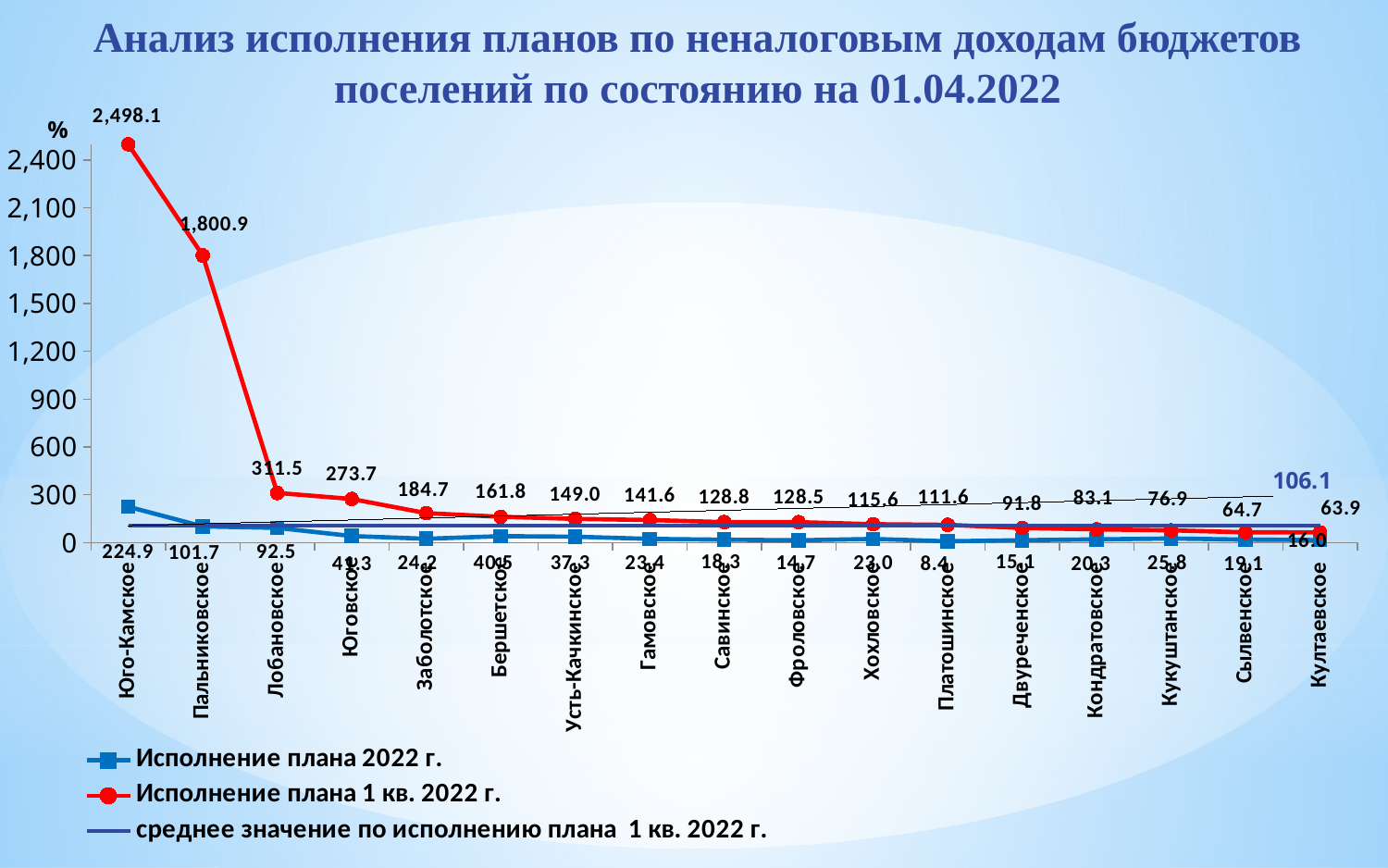
What is the difference between the 'Исполнение плана 1 кв. 2022 г.' values for Юго-Камское and Пальниковское? 697.2 What is the value of 'Исполнение плана 1 кв. 2022 г.' for Пальниковское? 1,800.9 How many settlements (categories) are plotted along the x axis? 17 Which settlement has the highest value for 'Исполнение плана 1 кв. 2022 г.'? Юго-Камское What is the value of 'Исполнение плана 1 кв. 2022 г.' for Юго-Камское? 2,498.1 Does the 'Исполнение плана 1 кв. 2022 г.' series rise or fall from left to right along the x axis? fall What kind of chart is shown on the slide? line chart What is the value of 'Исполнение плана 2022 г.' for Юго-Камское? 224.9 Which has the larger 'Исполнение плана 1 кв. 2022 г.' value, Лобановское or Юговское? Лобановское What is the value shown for 'среднее значение по исполнению плана 1 кв. 2022 г.'? 106.1 Which settlement has the lowest value for 'Исполнение плана 1 кв. 2022 г.'? Култаевское How many series does the legend list? 3